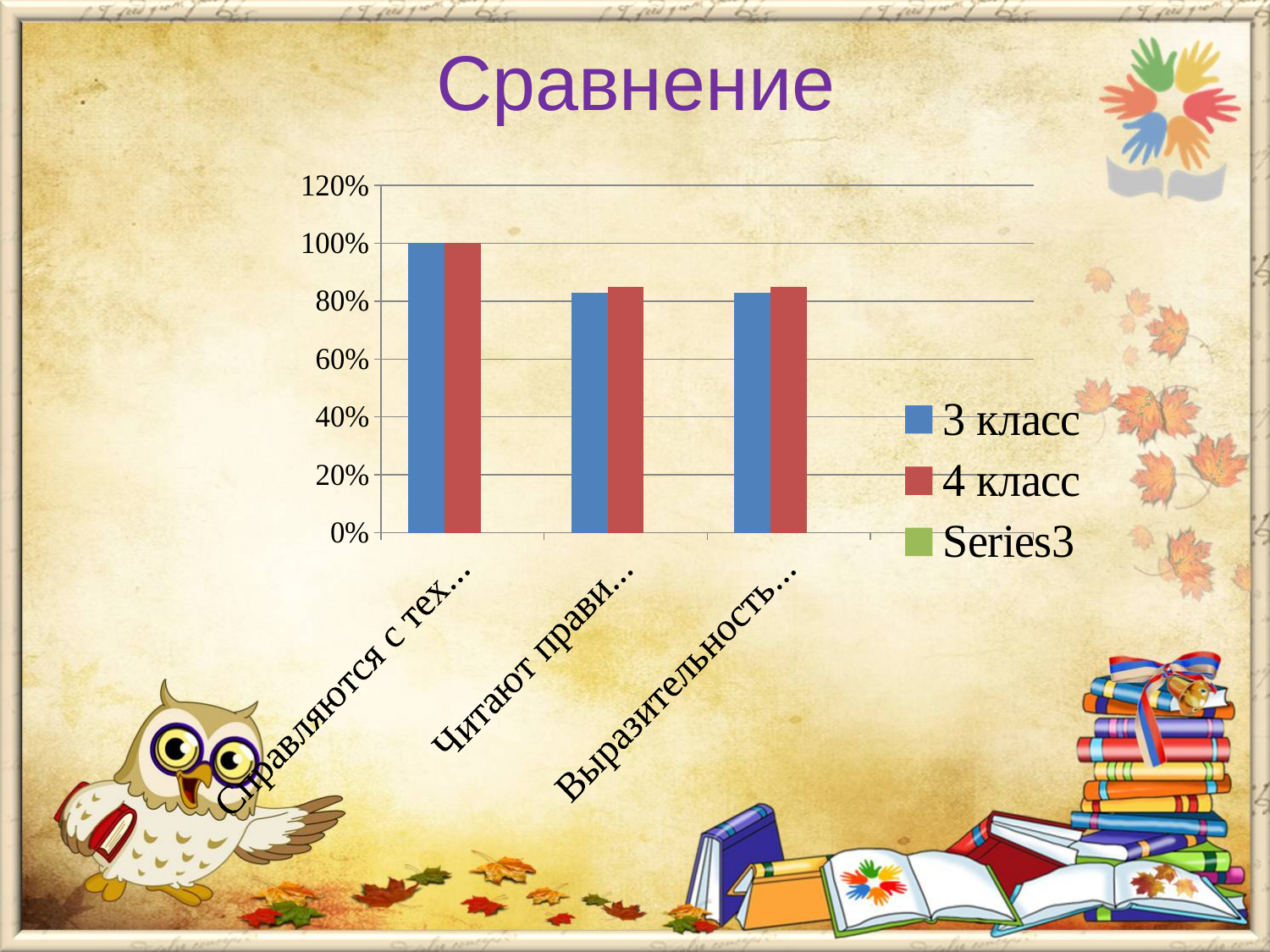
Is the value for 4 класс in the category Выразительность... greater or less than 60%? greater How many series does the legend list? 3 What is the value for 3 класс in the first category (Справляются с тех...)? 100% Does the 3 класс series rise or fall from the first category to the second category? fall What is the title of the chart? Сравнение What kind of chart is shown on the slide? bar chart Which legend entry has no visible bars in the chart? Series3 Is the value for 3 класс in the category Читают прави... greater or less than 100%? less What is the value for 4 класс in the first category (Справляются с тех...)? 100% How many categories are shown on the x axis? 3 For the 3 класс series, which category has the highest value? Справляются с тех... Which colour represents the 4 класс series in the legend? red